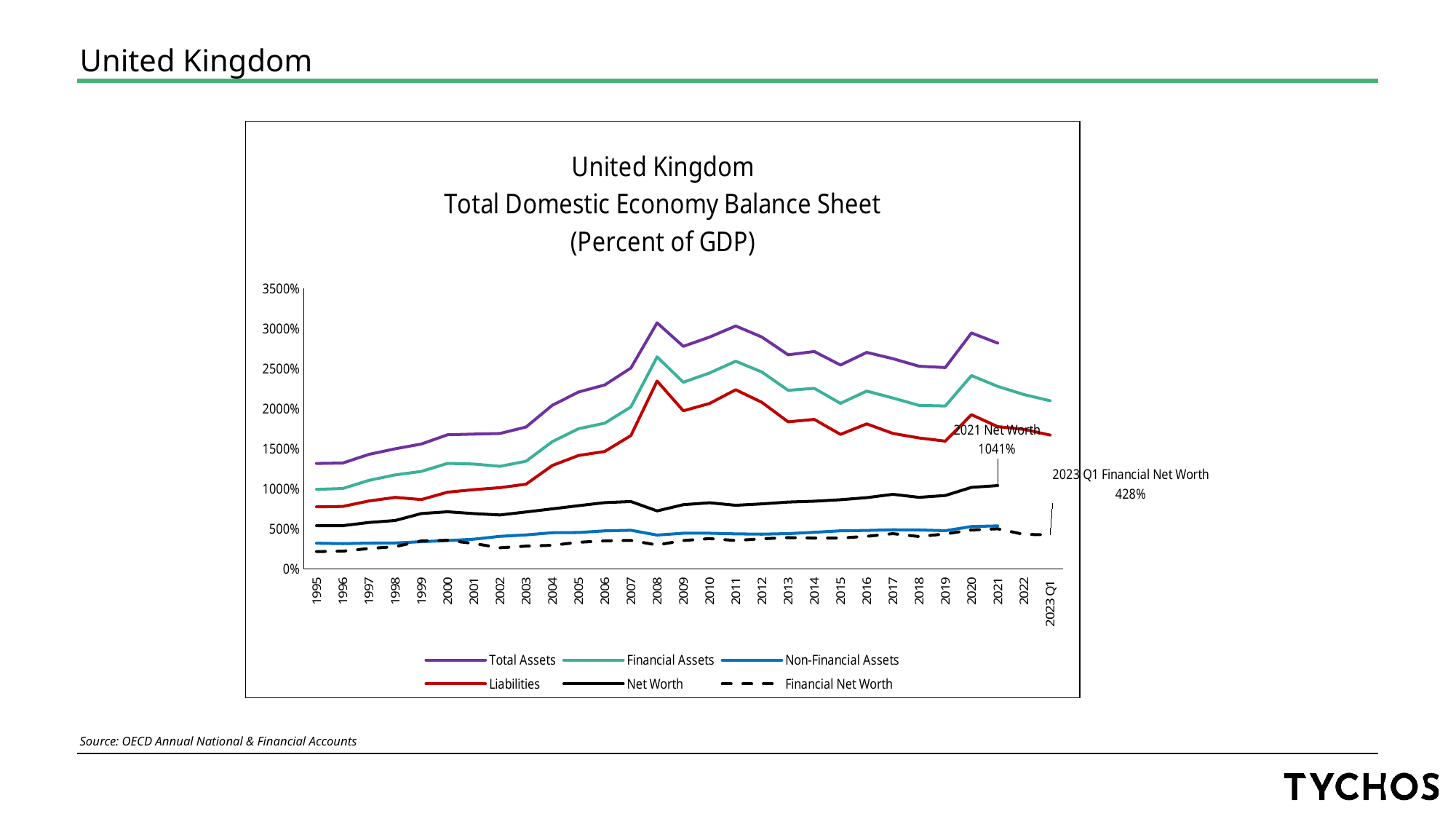
Is the value for Total Assets in 2008 greater or less than 2500%? greater What is the title of the chart? United Kingdom Total Domestic Economy Balance Sheet (Percent of GDP) Do Total Assets rise or fall from 1995 to 2008? Rise What is the value of Net Worth in 2021? 1041% In 2021, which is larger: Financial Assets or Liabilities? Financial Assets What kind of chart is shown on the slide? Line chart Which series is drawn with a dashed line? Financial Net Worth How many series does the legend list? 6 What is the value of Financial Net Worth in 2023 Q1? 428% Is the value for Net Worth in 1995 greater or less than 1000%? less Which series has the highest values across the whole period? Total Assets Is the value for Non-Financial Assets in 1995 greater or less than 500%? less